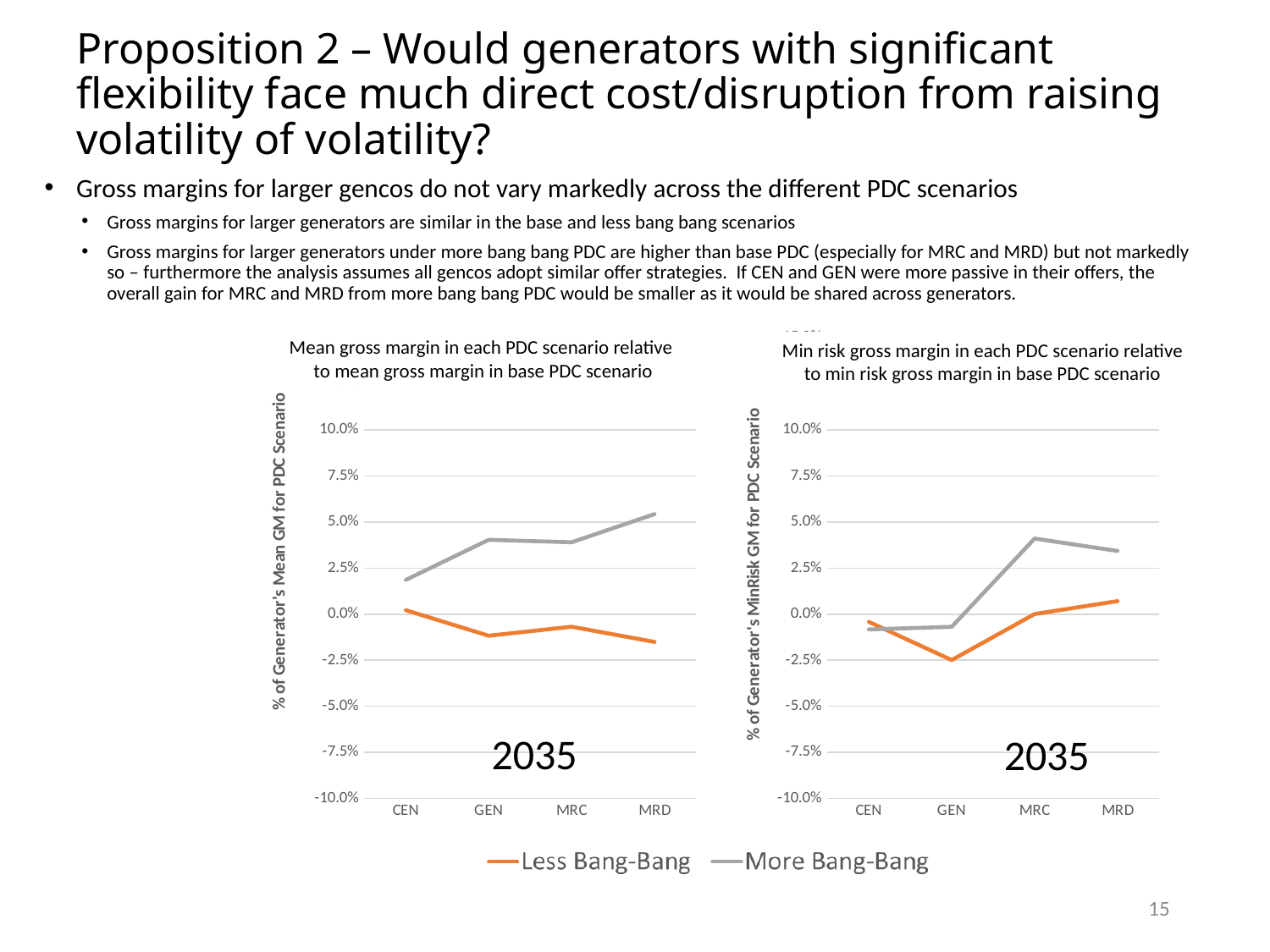
How many categories are shown on the x axis of the right chart, 'Min risk gross margin in each PDC scenario relative to min risk gross margin in base PDC scenario'? 4 In the left chart (mean gross margin), is the More Bang-Bang value for MRD greater or less than 5.0%? greater Which colour is used for the Less Bang-Bang series in the legend? Orange In the right chart (min risk gross margin), does the More Bang-Bang line rise or fall from GEN to MRC? Rise In the left chart (mean gross margin), which category has the lowest value for the Less Bang-Bang series? MRD In the left chart (mean gross margin), which category has the highest value for the More Bang-Bang series? MRD In the right chart (min risk gross margin), is the Less Bang-Bang value for GEN greater or less than 0.0%? less What kind of chart is the left chart, 'Mean gross margin in each PDC scenario relative to mean gross margin in base PDC scenario'? Line chart In the right chart (min risk gross margin), which category has the highest value for the More Bang-Bang series? MRC In the right chart (min risk gross margin), which category has the lowest value for the Less Bang-Bang series? GEN How many series does the legend list for the charts on the slide? 2 In the left chart (mean gross margin), which series has the larger value at GEN, Less Bang-Bang or More Bang-Bang? More Bang-Bang